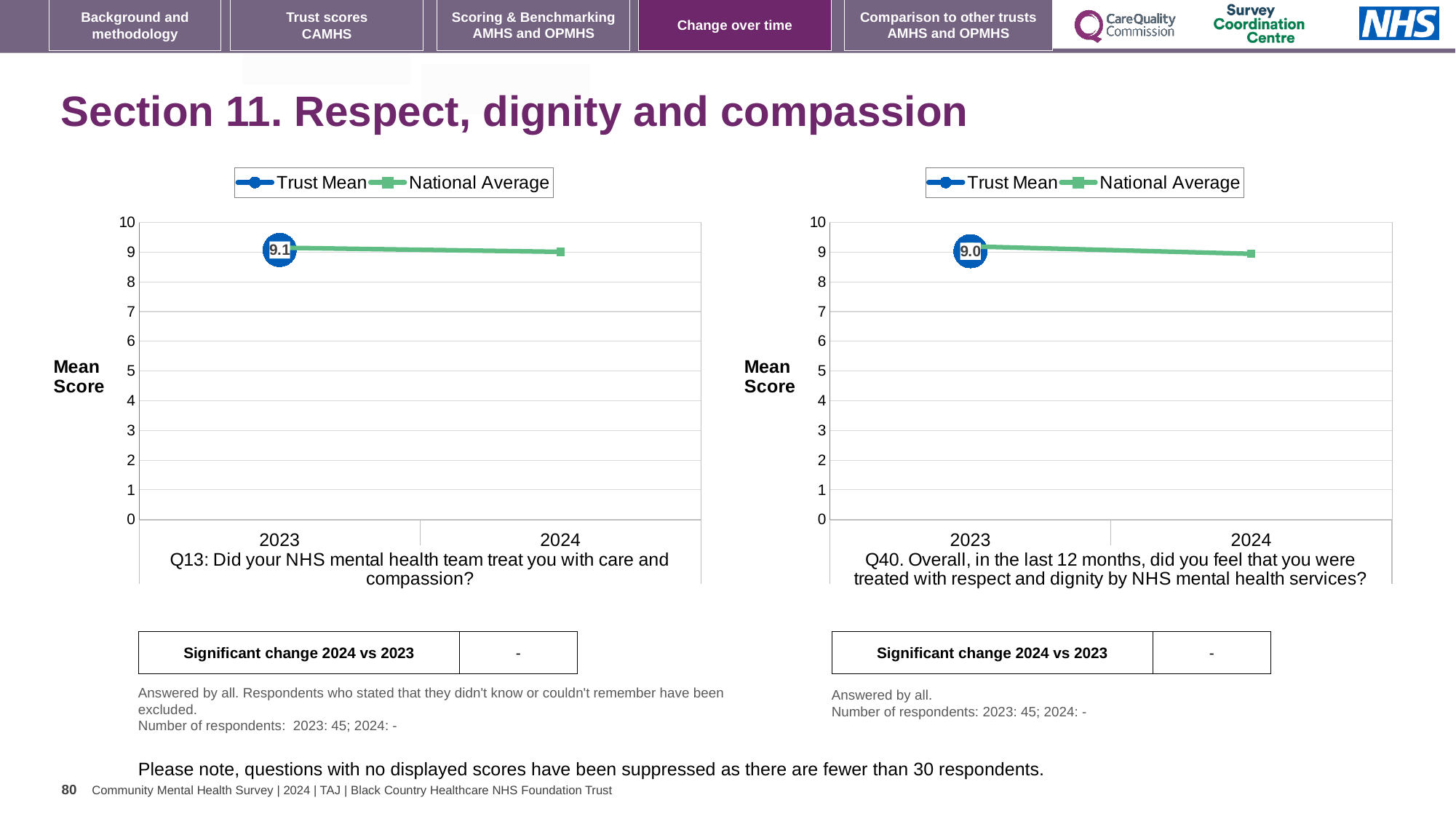
How many years are shown on the x axis of the left chart (Q13)? 2 What kind of chart is the left chart (Q13)? Line chart In the left chart (Q13), is the Trust Mean value for 2023 greater or less than 5? greater In the left chart (Q13), is the National Average value for 2024 greater or less than 8? greater In the left chart (Q13), what is the Trust Mean score for 2023? 9.1 How many series does the legend of the right chart (Q40) list? 2 In the right chart (Q40), what is the Trust Mean score for 2023? 9.0 In the right chart (Q40), is the National Average value for 2024 greater or less than 8? greater In the right chart (Q40), does the National Average line rise or fall from 2023 to 2024? fall What is the label on the y axis of the right chart (Q40)? Mean Score What are the two series named in the legend of the left chart (Q13)? Trust Mean and National Average